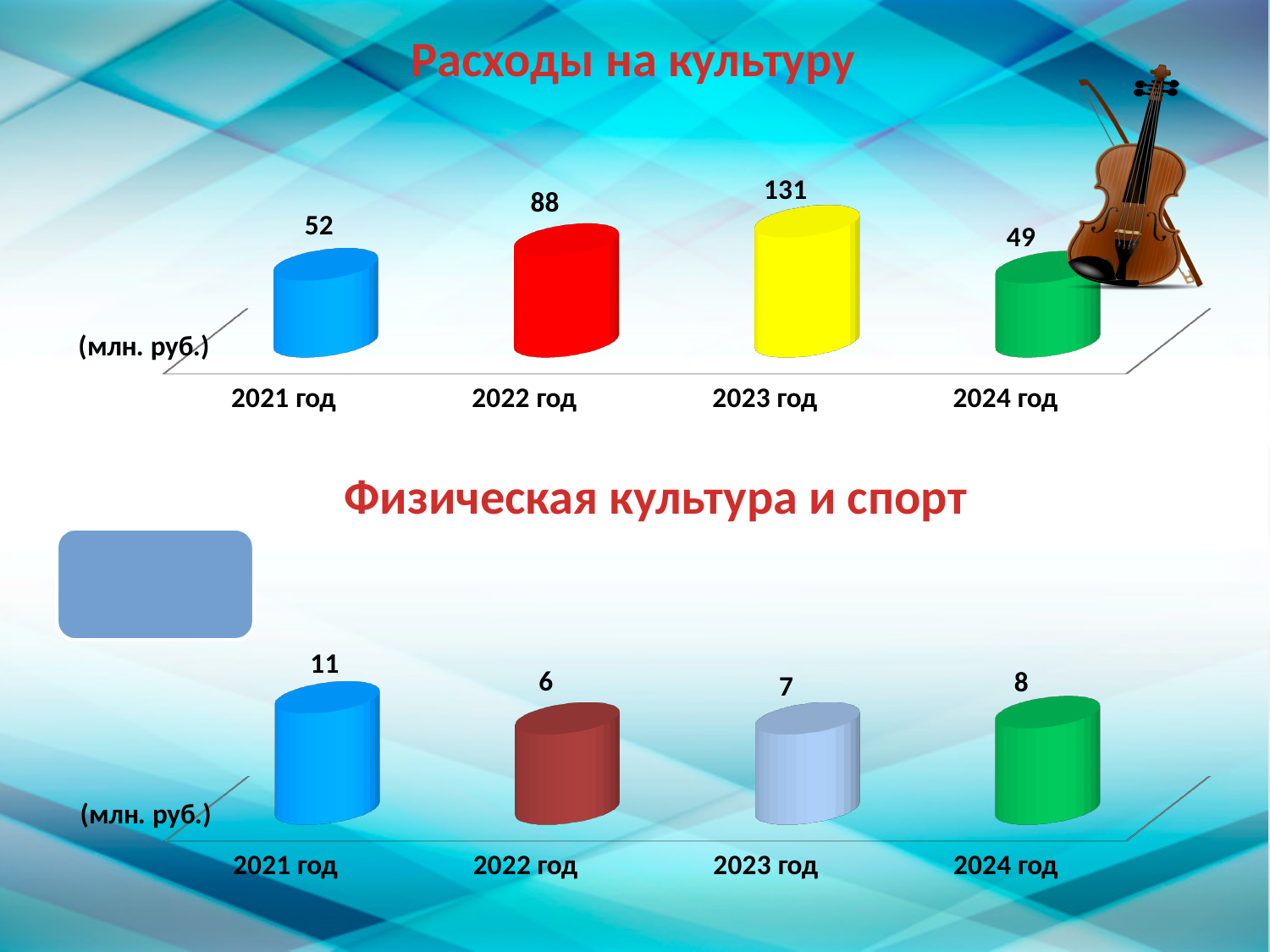
In the chart titled "Физическая культура и спорт", what is the value for 2022 год? 6 How many years are shown in the chart titled "Физическая культура и спорт"? 4 In the chart titled "Расходы на культуру", which year has the lowest value? 2024 год In the chart titled "Расходы на культуру", which year has the highest value? 2023 год In the chart titled "Физическая культура и спорт", what is the difference between the values for 2021 год and 2024 год? 3 In the chart titled "Расходы на культуру", which is larger: the value for 2021 год or the value for 2024 год? 2021 год In the chart titled "Расходы на культуру", what is the value for 2024 год? 49 In the chart titled "Физическая культура и спорт", which year has the lowest value? 2022 год In the chart titled "Расходы на культуру", what is the difference between the values for 2023 год and 2022 год? 43 In the chart titled "Физическая культура и спорт", what is the value for 2021 год? 11 What type of chart is the chart titled "Расходы на культуру"? Bar chart In the chart titled "Расходы на культуру", what is the value for 2023 год? 131